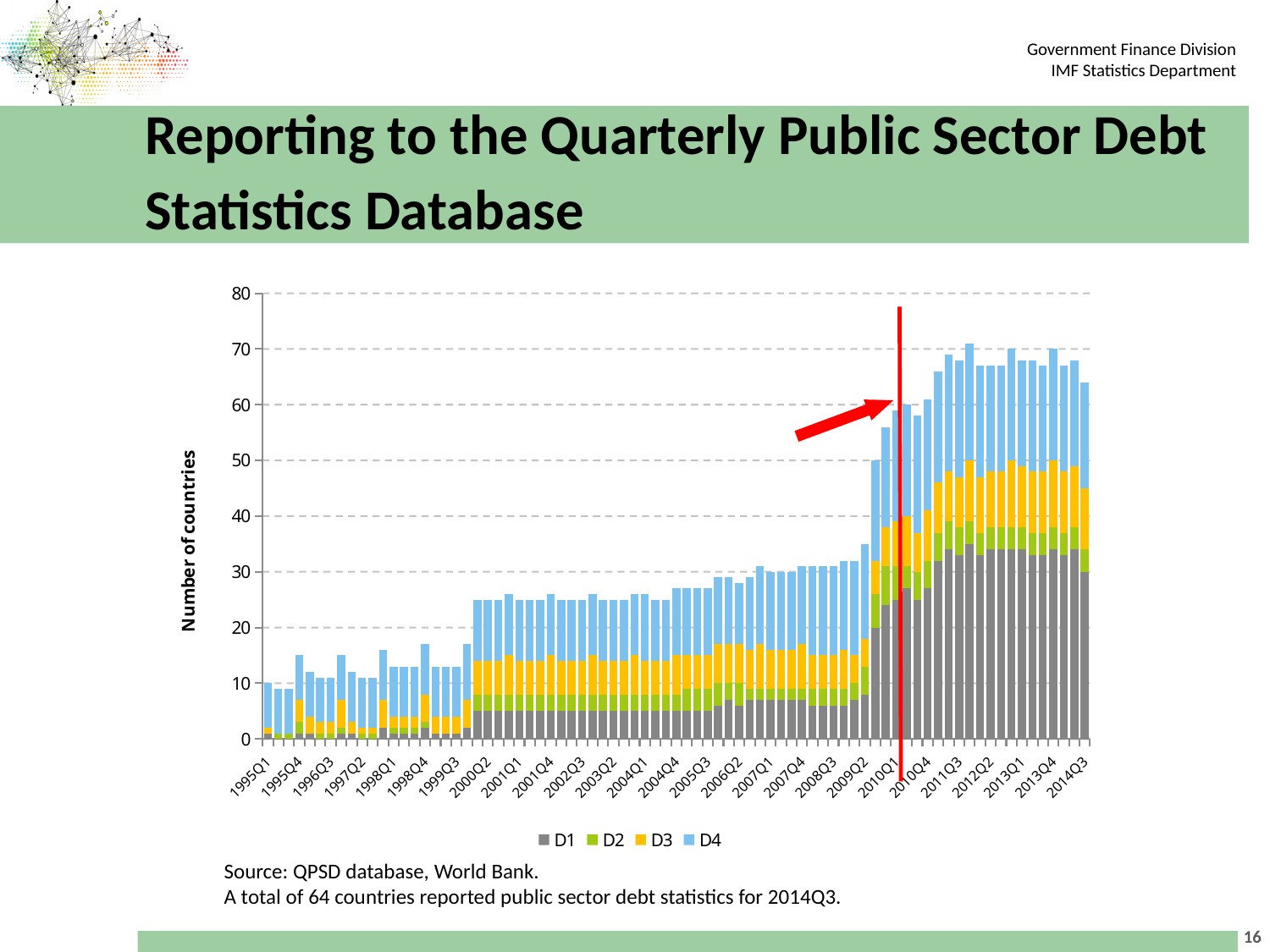
Is the total number of countries for 2000Q2 greater or less than 30? less How many series does the chart's legend list? 4 Is the total number of countries for 2009Q2 greater or less than 30? greater Overall, does the total number of countries rise or fall from 1995Q1 to 2014Q3? rise What are the series names listed in the chart's legend? D1, D2, D3, D4 Is the total number of countries for 2011Q3 greater or less than 60? greater What is the label on the vertical axis of the chart? Number of countries According to the slide, how many countries in total reported public sector debt statistics for 2014Q3? 64 Which quarter has a higher total number of countries, 2000Q2 or 2010Q1? 2010Q1 Which quarter has a higher total number of countries, 2009Q2 or 2014Q3? 2014Q3 What kind of chart is shown on the slide? Stacked bar chart